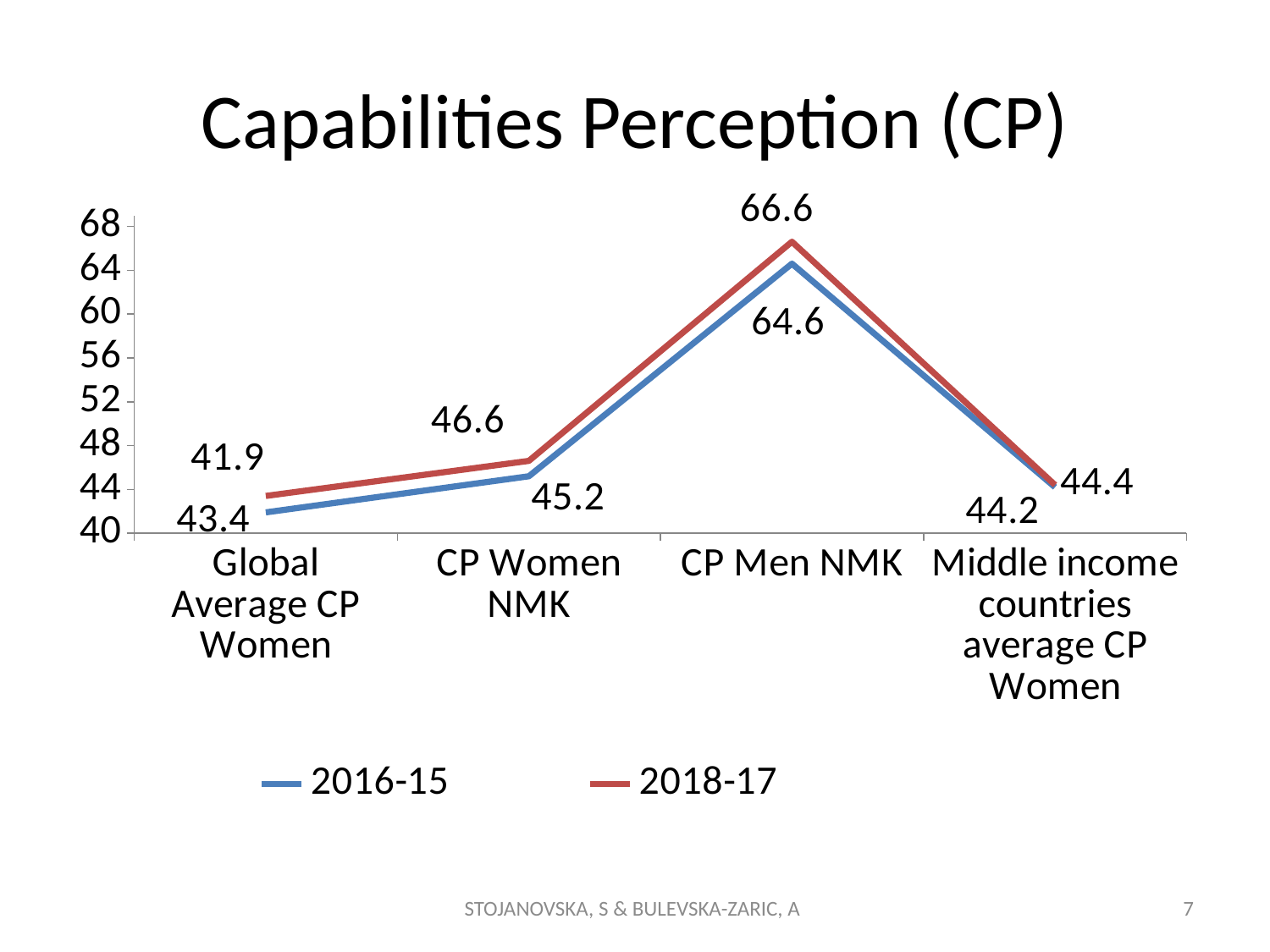
What is the title of the chart? Capabilities Perception (CP) What is the 2018-17 value for CP Men NMK? 66.6 For CP Women NMK, which series has the larger value, 2016-15 or 2018-17? 2018-17 How many series does the legend list? 2 Which category has the lowest value for the 2016-15 series? Global Average CP Women What kind of chart is shown on the slide? line chart Which category has the highest value for the 2018-17 series? CP Men NMK How many categories are shown on the x axis? 4 What is the 2016-15 value for Middle income countries average CP Women? 44.2 What is the difference between the 2018-17 and 2016-15 values for CP Men NMK? 2.0 What is the 2018-17 value for CP Women NMK? 46.6 What is the 2016-15 value for CP Men NMK? 64.6